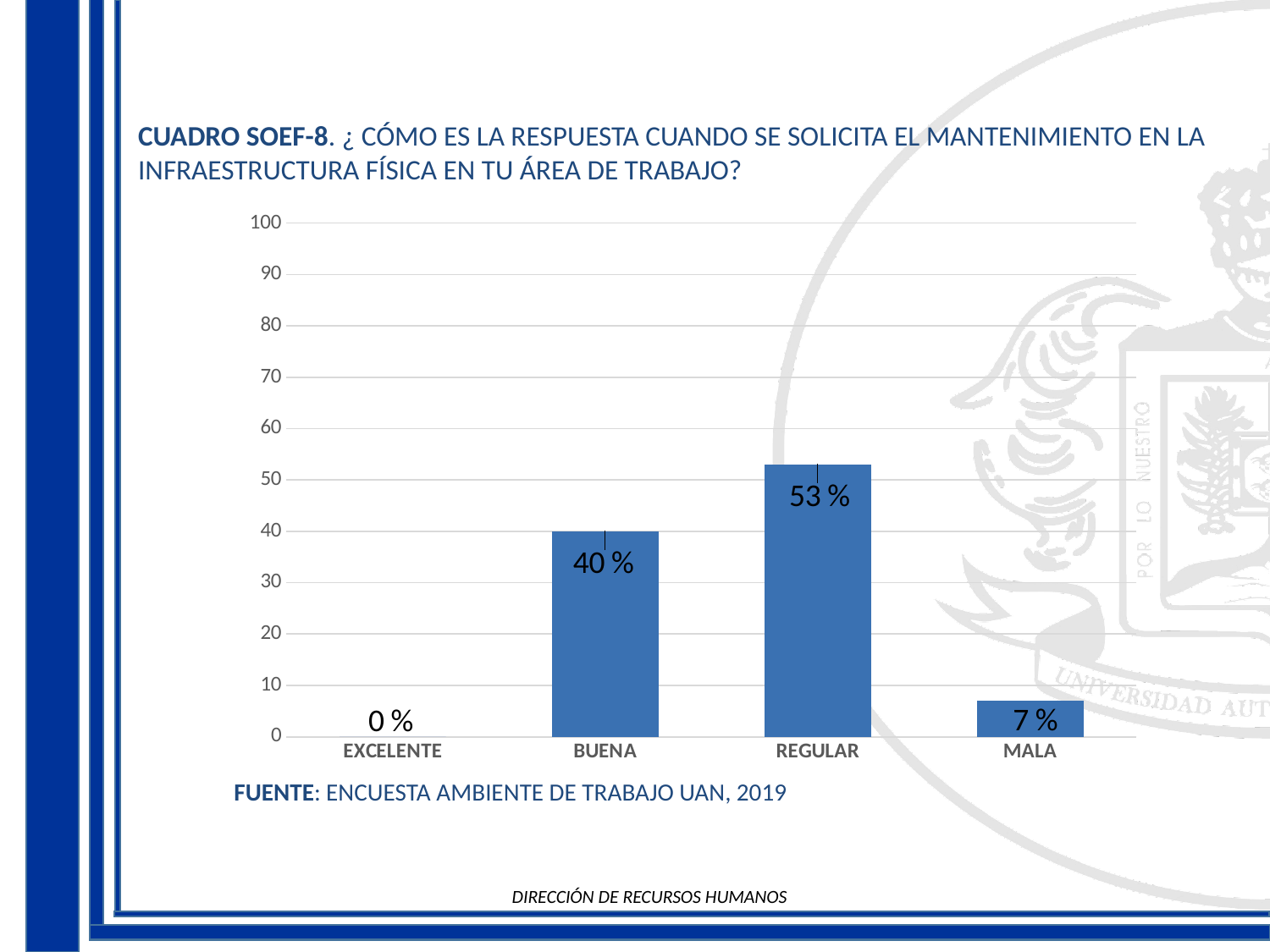
What is the value for EXCELENTE? 0 % What is the difference between the values for REGULAR and BUENA? 13 % What source is cited below the chart? ENCUESTA AMBIENTE DE TRABAJO UAN, 2019 Which category has the highest value? REGULAR Which is larger, the value for BUENA or the value for MALA? BUENA What is the value for BUENA? 40 % Which category has the lowest value? EXCELENTE What is the value for REGULAR? 53 % What is the value for MALA? 7 % What kind of chart is shown on the slide? bar chart Is the value for REGULAR greater or less than 50? greater How many categories are shown on the x axis? 4